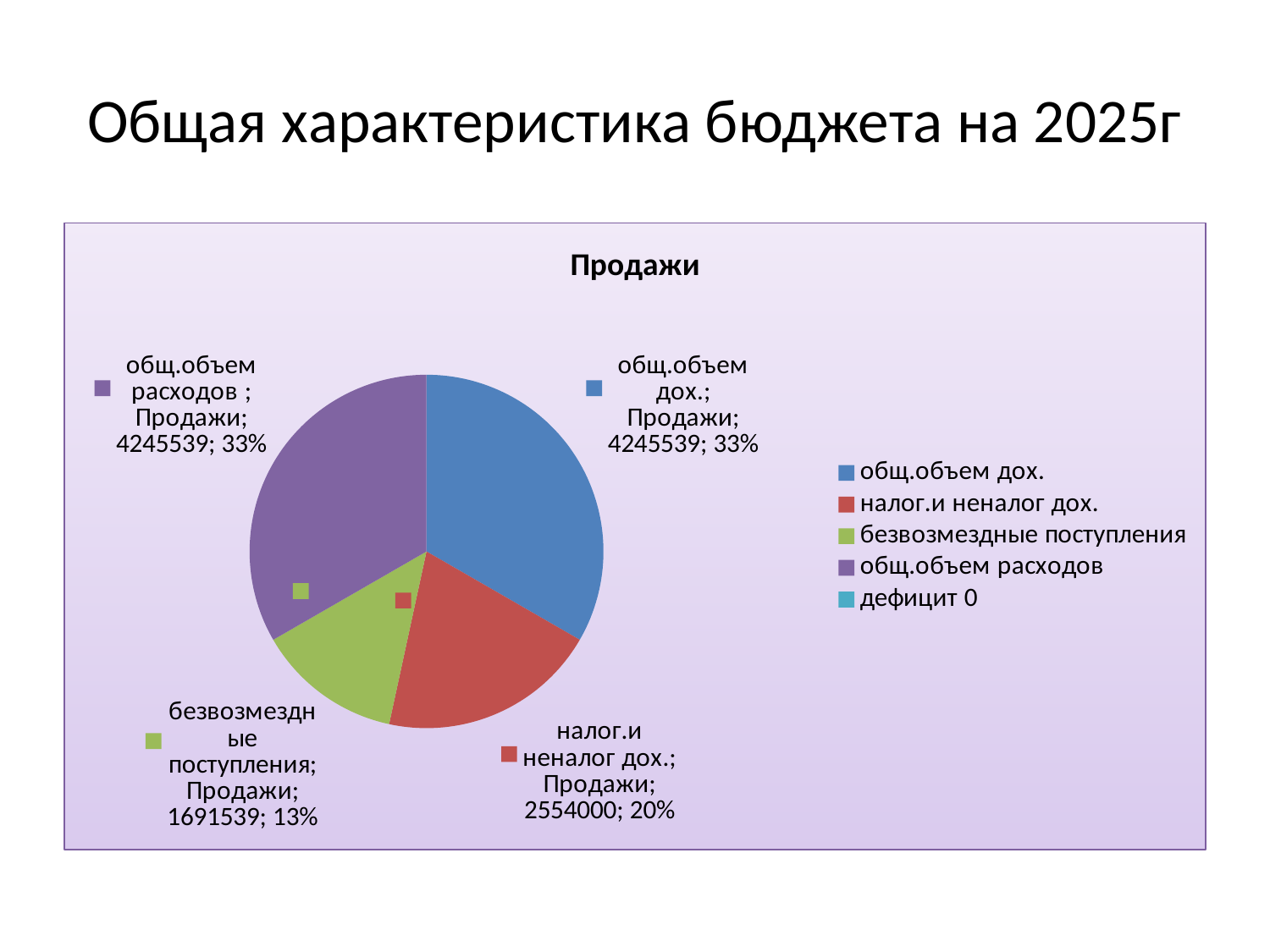
What share of the pie does общ.объем расходов represent? 33% Which is larger, налог.и неналог дох. or безвозмездные поступления? налог.и неналог дох. What type of chart is shown on the slide? pie chart What value is shown for общ.объем расходов? 4245539 What is the difference between the values for общ.объем дох. and налог.и неналог дох.? 1691539 What is the title of the chart? Продажи What share of the pie does безвозмездные поступления represent? 13% What value is shown for безвозмездные поступления? 1691539 What share of the pie does налог.и неналог дох. represent? 20% What value is shown for общ.объем дох.? 4245539 What value is shown for налог.и неналог дох.? 2554000 How many entries does the legend list? 5